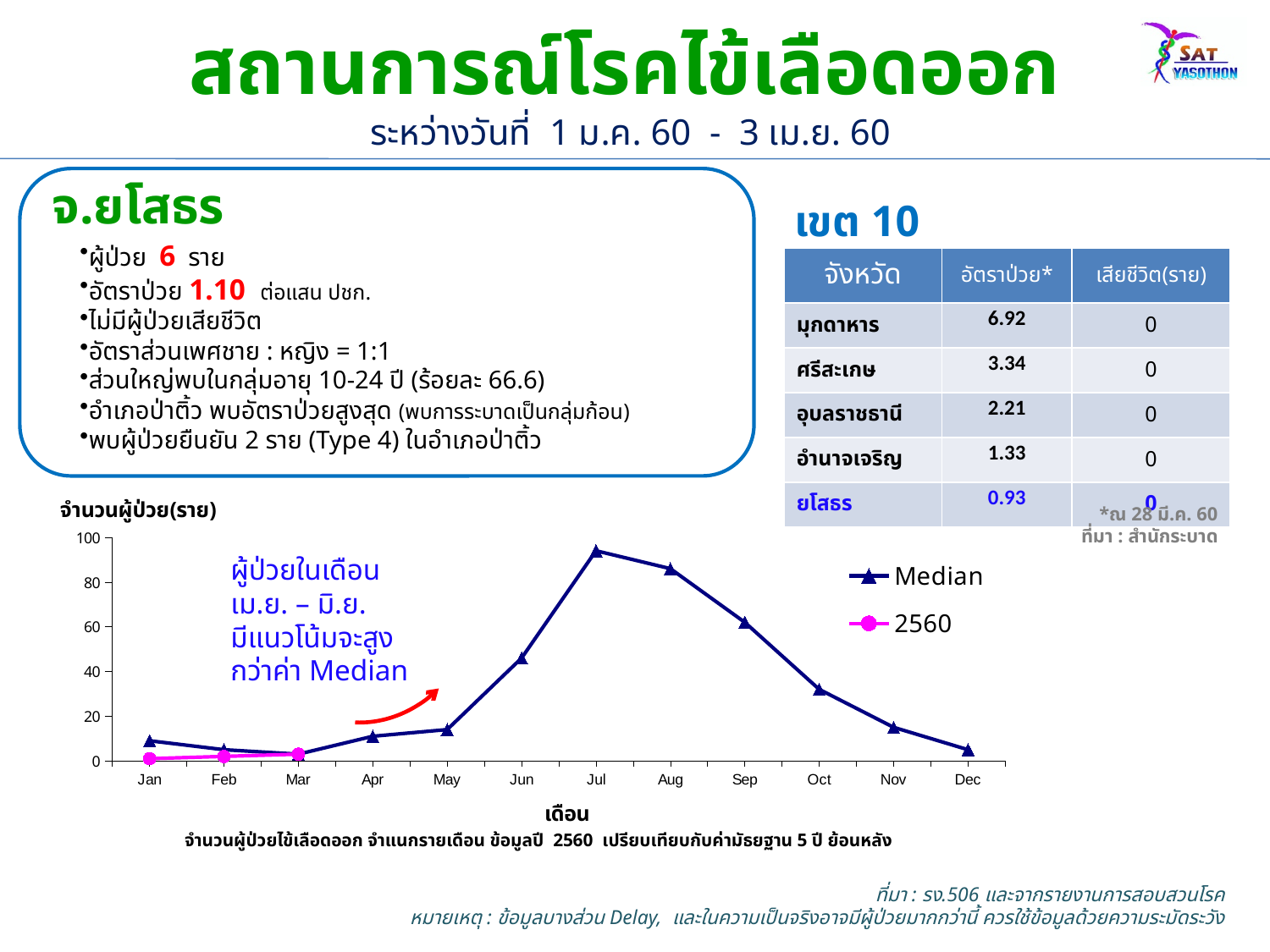
For how many months does the 2560 series have plotted points? 3 Is the Median value for Oct greater or less than 40? less What are the two series names listed in the chart legend? Median and 2560 Is the Median value for Jul greater or less than 80? greater In which month does the Median series reach its highest value? Jul Which is larger, the Median value for Jun or the Median value for Oct? Jun How many series does the chart legend list? 2 Is the Median value for Jun greater or less than 40? greater What kind of chart is shown on the slide? line chart How many months are shown along the x axis of the chart? 12 Which is larger, the Median value for Jul or the Median value for Aug? Jul Does the Median series rise or fall from Jul to Dec? fall